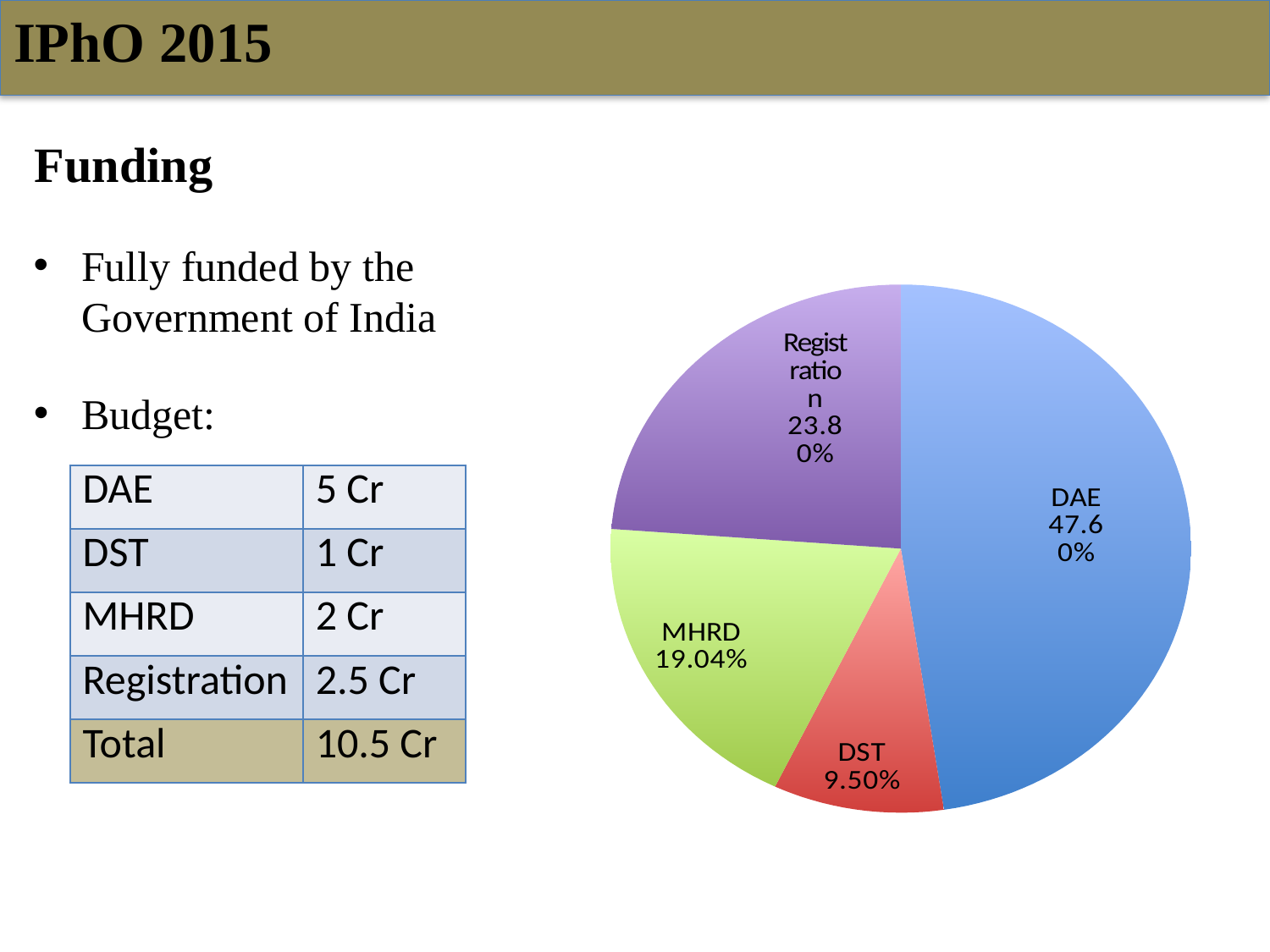
What share of the pie does DAE account for? 47.60% What share of the pie does Registration account for? 23.80% What is the difference in percentage points between the DAE and Registration slices? 23.80% What share of the pie does MHRD account for? 19.04% Which slice of the pie chart is the smallest? DST How many slices does the pie chart have? 4 What is the difference in percentage points between the MHRD and DST slices? 9.54% What colour is the DAE slice in the pie chart? blue Which is larger in the pie chart, MHRD or Registration? Registration What kind of chart is shown on the slide? pie chart Which slice of the pie chart is the largest? DAE